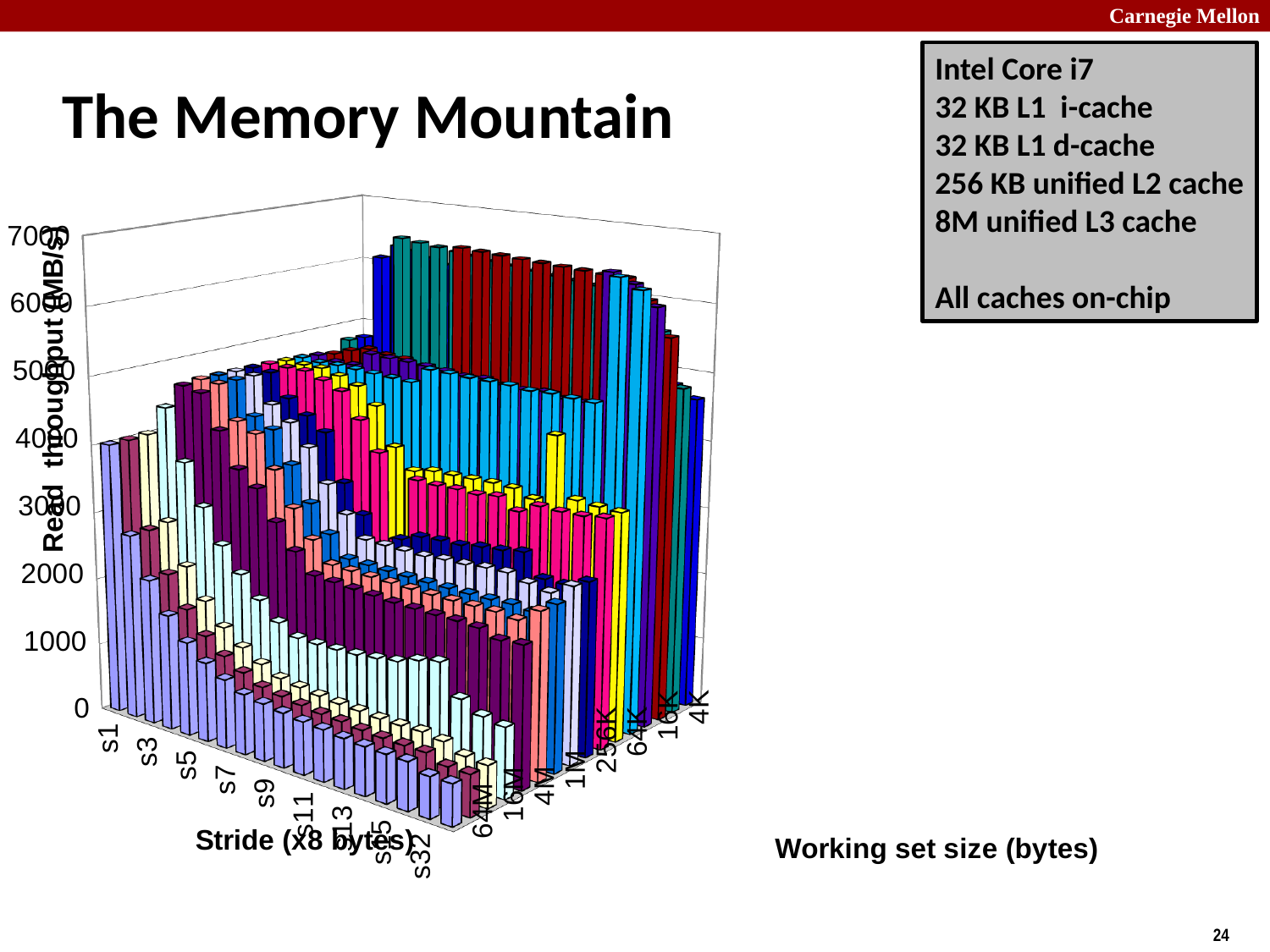
Is the read throughput for stride s32 at a working set size of 64M greater or less than 2000? less For a working set size of 64M, does read throughput rise or fall as the stride increases from s1 to s32? fall What is the label of the vertical axis of the chart? Read throughput (MB/s) How many working set size labels are printed along the working set size axis? 8 Which working set size label is the smallest shown on the working set size axis? 4K Is the read throughput for stride s1 at a working set size of 4K greater or less than 5000? less What is the title of the chart on the slide? The Memory Mountain What is the highest tick value shown on the read throughput axis? 7000 How many stride labels are printed along the stride axis? 9 For stride s1, does read throughput rise or fall as the working set size decreases from 64M to 4K? rise What kind of chart is shown on the slide? 3D bar chart Which working set size label is the largest shown on the working set size axis? 64M